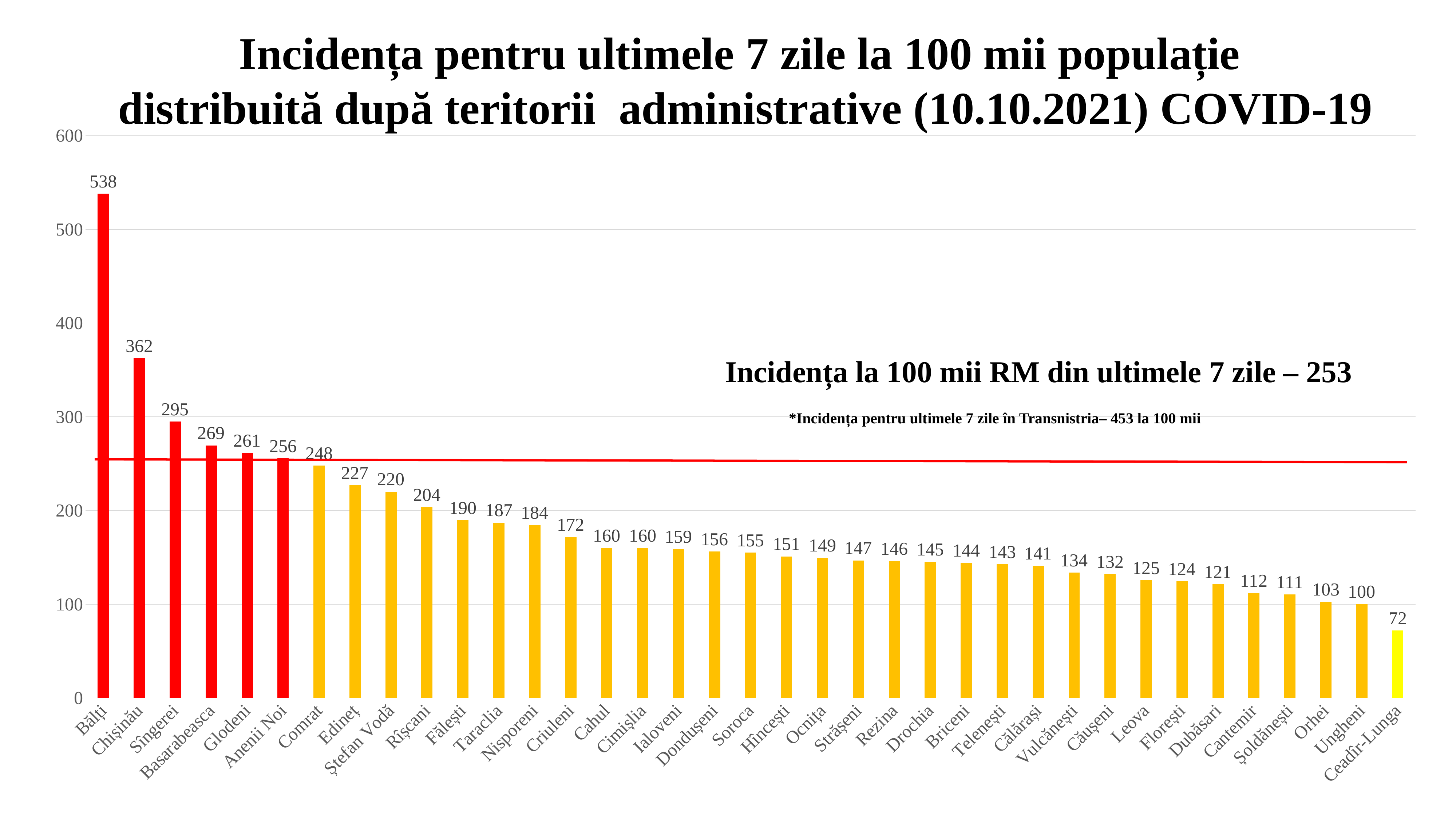
Which has a higher incidence, Edineț or Rîșcani? Edineț Do the values rise or fall from left to right along the x axis? Fall What is the incidence value for Orhei? 103 Which territory has the highest incidence? Bălți What is the incidence value for Chișinău? 362 How many territories are shown on the chart? 37 What is the national incidence per 100 thousand for the last 7 days stated on the slide? 253 What is the incidence value for Bălți? 538 Which territory has the lowest incidence? Ceadîr-Lunga What is the incidence value for Comrat? 248 What is the difference between the incidence values for Bălți and Chișinău? 176 What kind of chart is shown on the slide? Bar chart